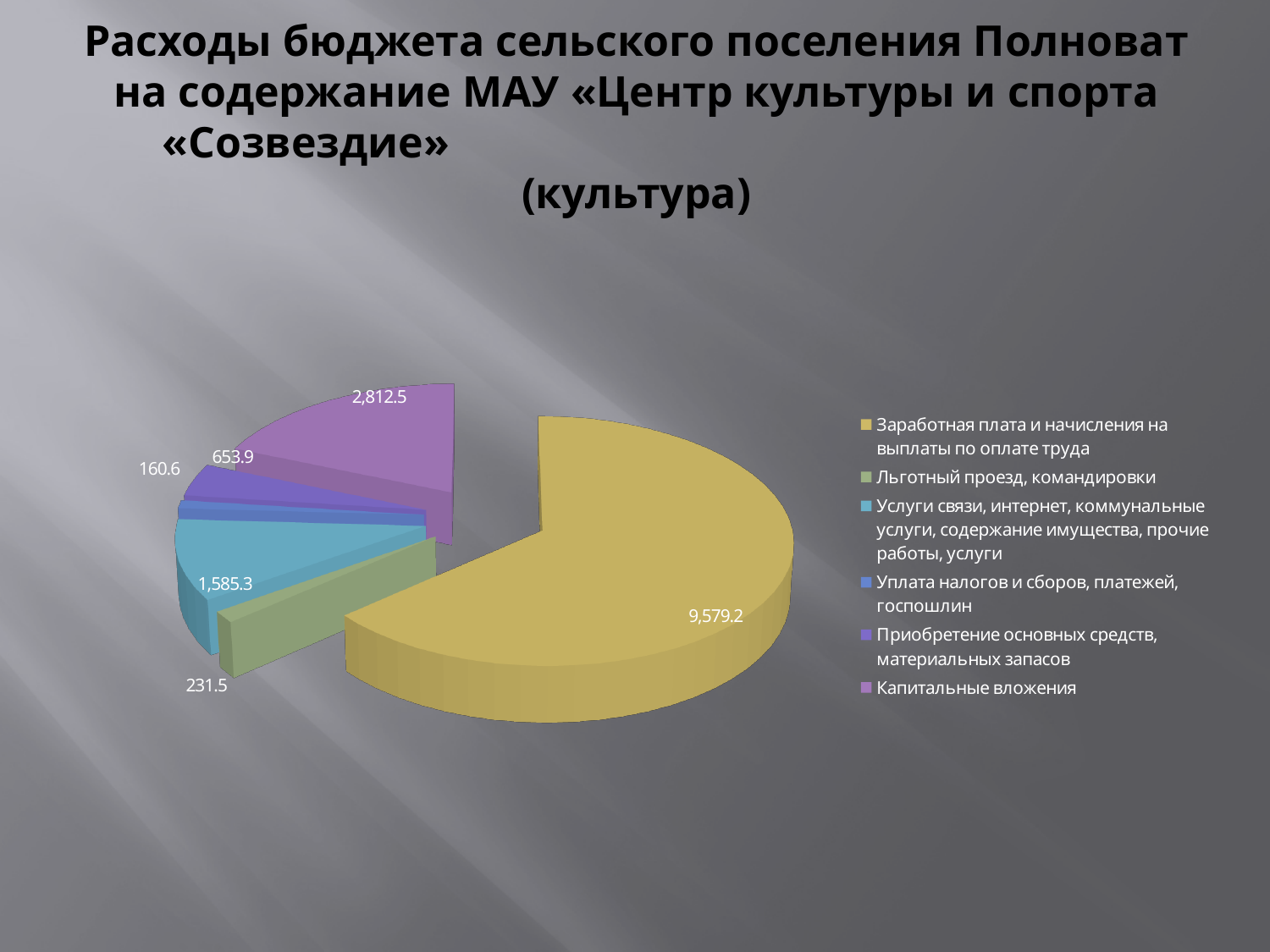
What is the total of all the slices in the pie chart? 15,023.0 How many entries does the legend list? 6 What is the value for «Капитальные вложения»? 2,812.5 What is the value for «Заработная плата и начисления на выплаты по оплате труда»? 9,579.2 What is the difference between the values for «Заработная плата и начисления на выплаты по оплате труда» and «Капитальные вложения»? 6,766.7 Which is larger: the value for «Приобретение основных средств, материальных запасов» or the value for «Уплата налогов и сборов, платежей, госпошлин»? Приобретение основных средств, материальных запасов What type of chart is shown on the slide? Pie chart What is the value for «Услуги связи, интернет, коммунальные услуги, содержание имущества, прочие работы, услуги»? 1,585.3 How many slices does the pie chart have? 6 Which category has the smallest slice of the pie? Уплата налогов и сборов, платежей, госпошлин What is the value for «Льготный проезд, командировки»? 231.5 Which category has the largest slice of the pie? Заработная плата и начисления на выплаты по оплате труда